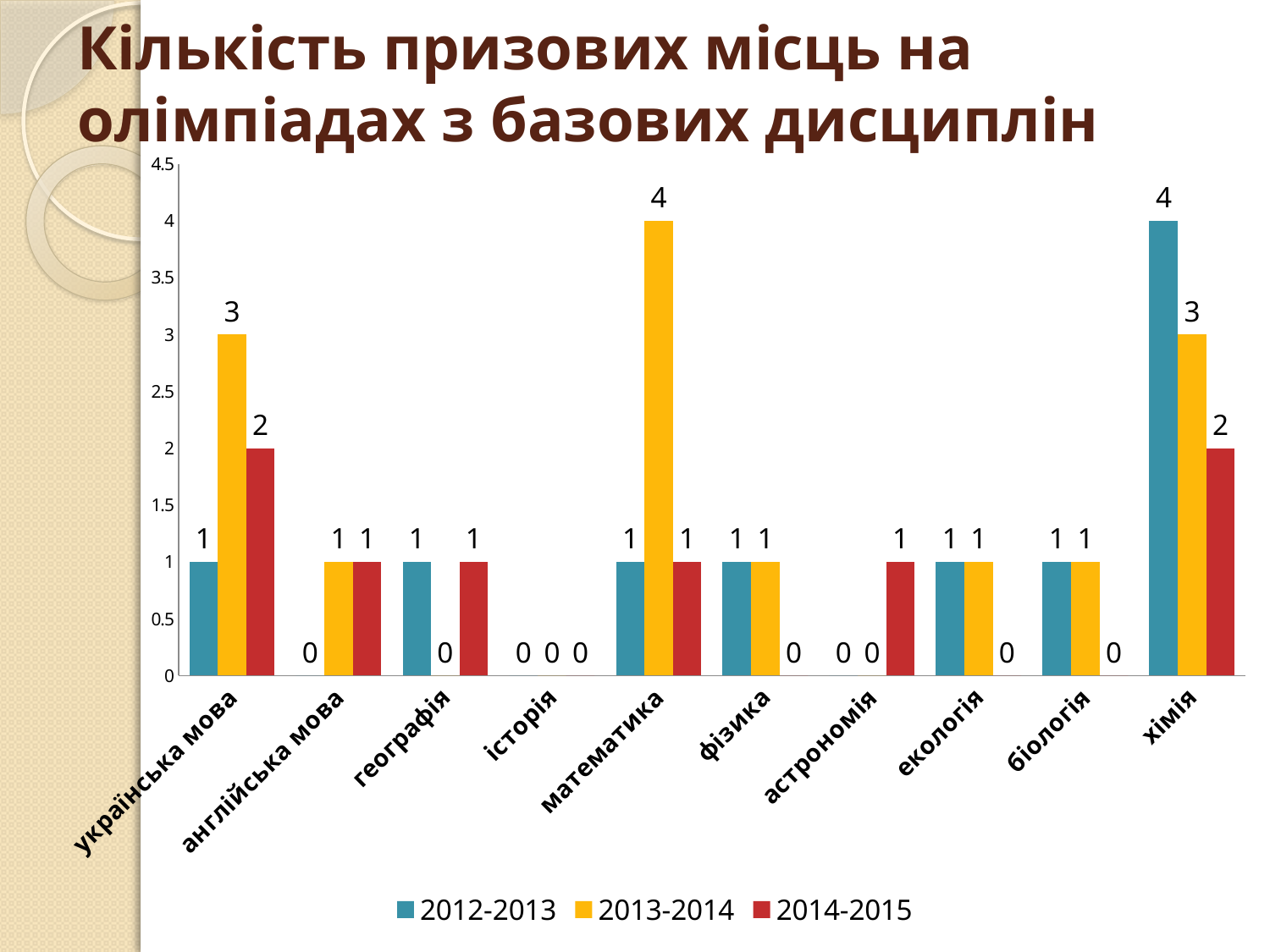
Which is larger for хімія: the 2012-2013 value or the 2014-2015 value? 2012-2013 What is the total of the three series values for хімія? 9 What is the value for астрономія in the 2014-2015 series? 1 Which category has the highest value in the 2012-2013 series? хімія What is the value for хімія in the 2012-2013 series? 4 What is the difference between the 2013-2014 and 2014-2015 values for українська мова? 1 What is the value for математика in the 2013-2014 series? 4 Which category has the highest value in the 2013-2014 series? математика How many series does the legend list? 3 What is the value for українська мова in the 2014-2015 series? 2 What kind of chart is shown on the slide? bar chart How many categories are shown on the x axis? 10